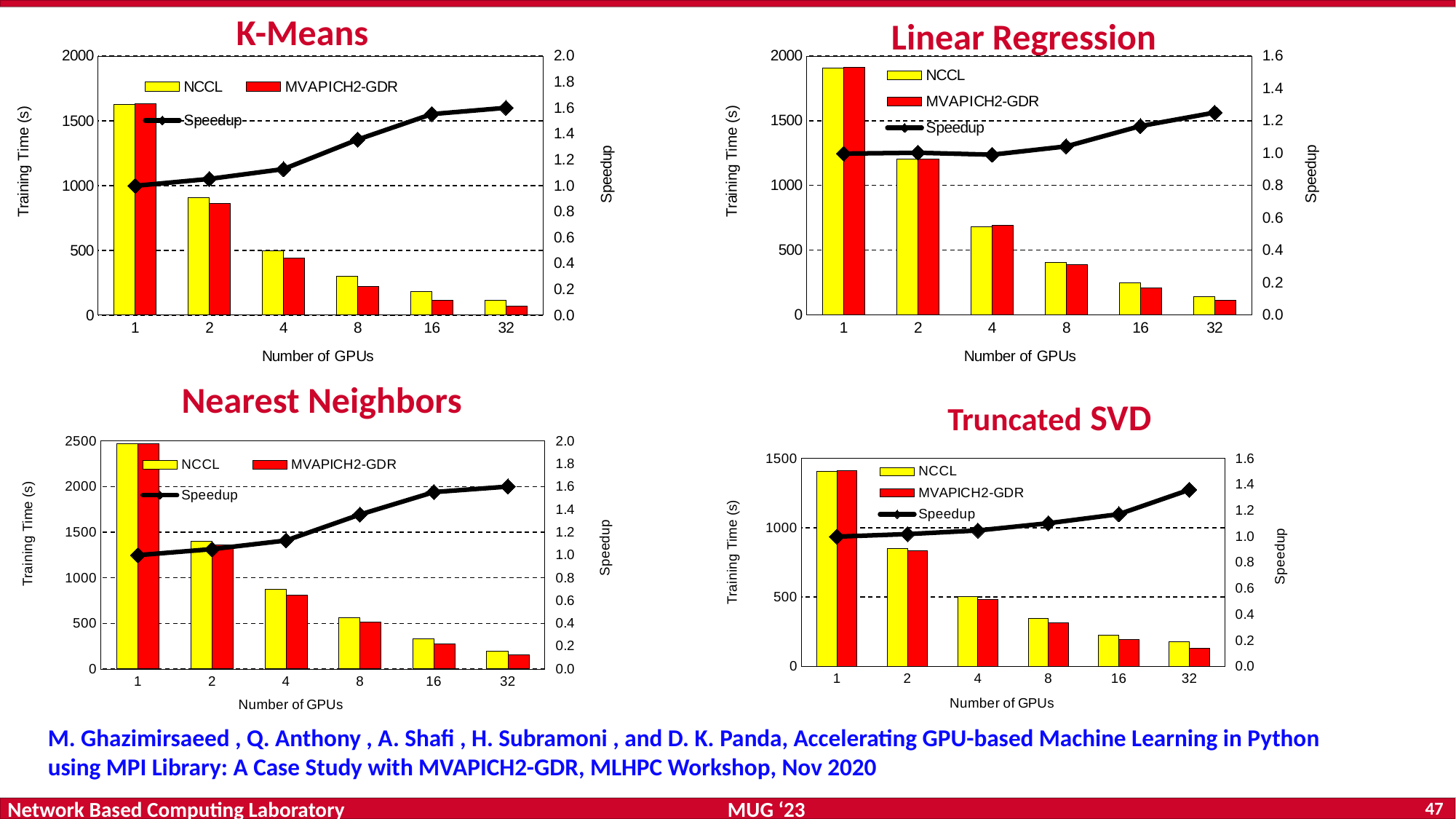
In the Nearest Neighbors chart, is the NCCL training time for 1 GPU greater or less than 2000? greater In the Linear Regression chart, what colour are the MVAPICH2-GDR bars? red In the K-Means chart, at 2 GPUs, which is larger: the NCCL training time or the MVAPICH2-GDR training time? NCCL In the K-Means chart, what kind of chart is used to show the training time? bar chart In the Linear Regression chart, how many GPU counts are shown on the x axis? 6 In the Linear Regression chart, is the Speedup at 32 GPUs greater or less than 1.0? greater In the K-Means chart, how many series does the legend list? 3 In the Nearest Neighbors chart, how does the Speedup change as the number of GPUs increases? It rises In the K-Means chart, is the NCCL training time for 1 GPU greater or less than 1500? greater In the Truncated SVD chart, which number of GPUs has the highest NCCL training time? 1 In the K-Means chart, how does the training time change as the number of GPUs increases? It falls